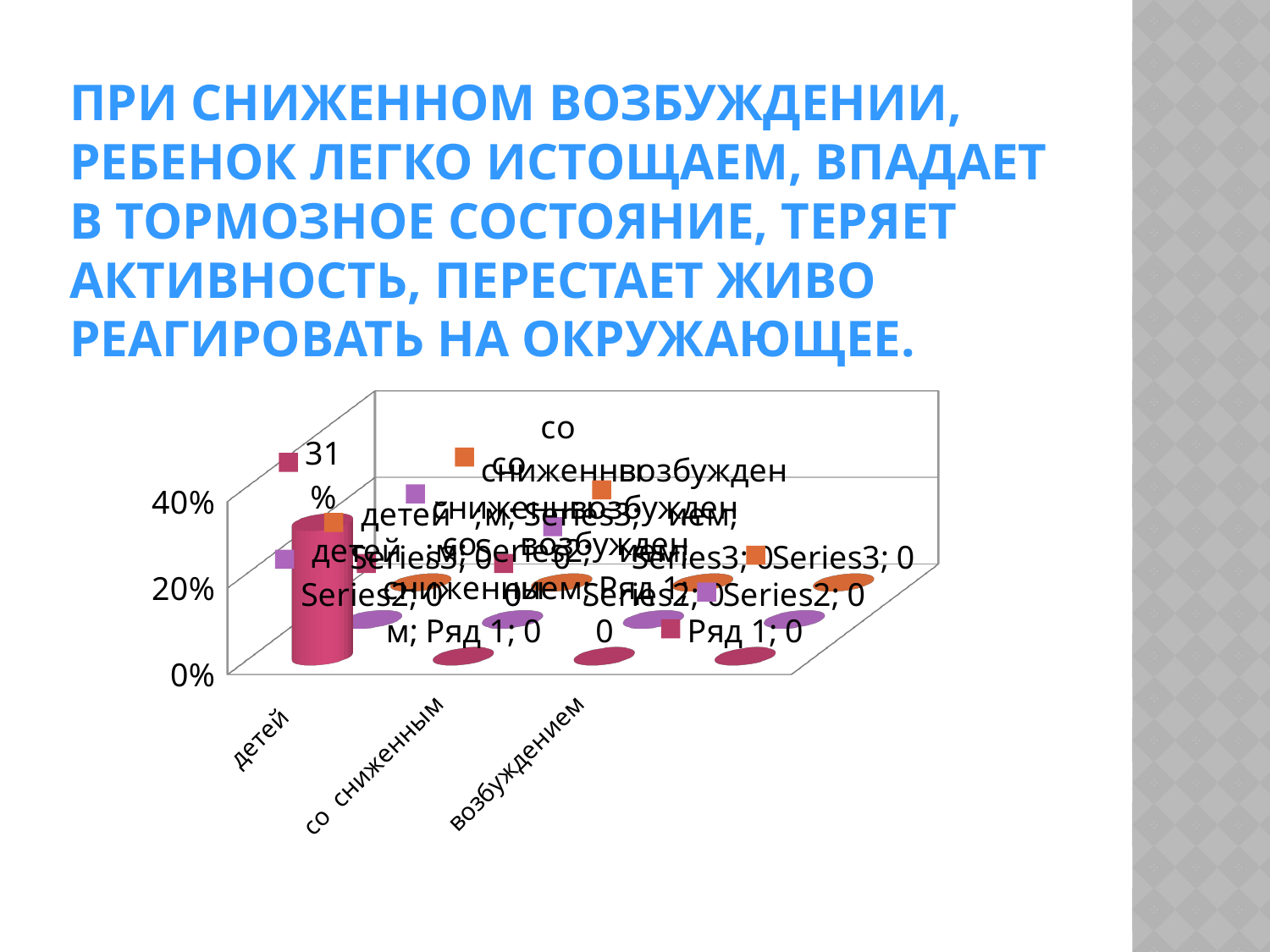
Which category on the x axis has the highest bar? детей What is the lowest tick label on the vertical axis of the chart? 0% Is the value for "детей" greater or less than 40%? less Is the value for "детей" greater or less than 20%? greater What value is shown in the data label for Series3 in the category "возбуждением"? 0 How many categories are shown along the x axis of the chart? 3 What kind of chart is shown on the slide? bar chart What is the highest tick label on the vertical axis of the chart? 40% What value is labelled on the tall bar for the category "детей"? 31% What value is shown in the data label for Series2 in the category "возбуждением"? 0